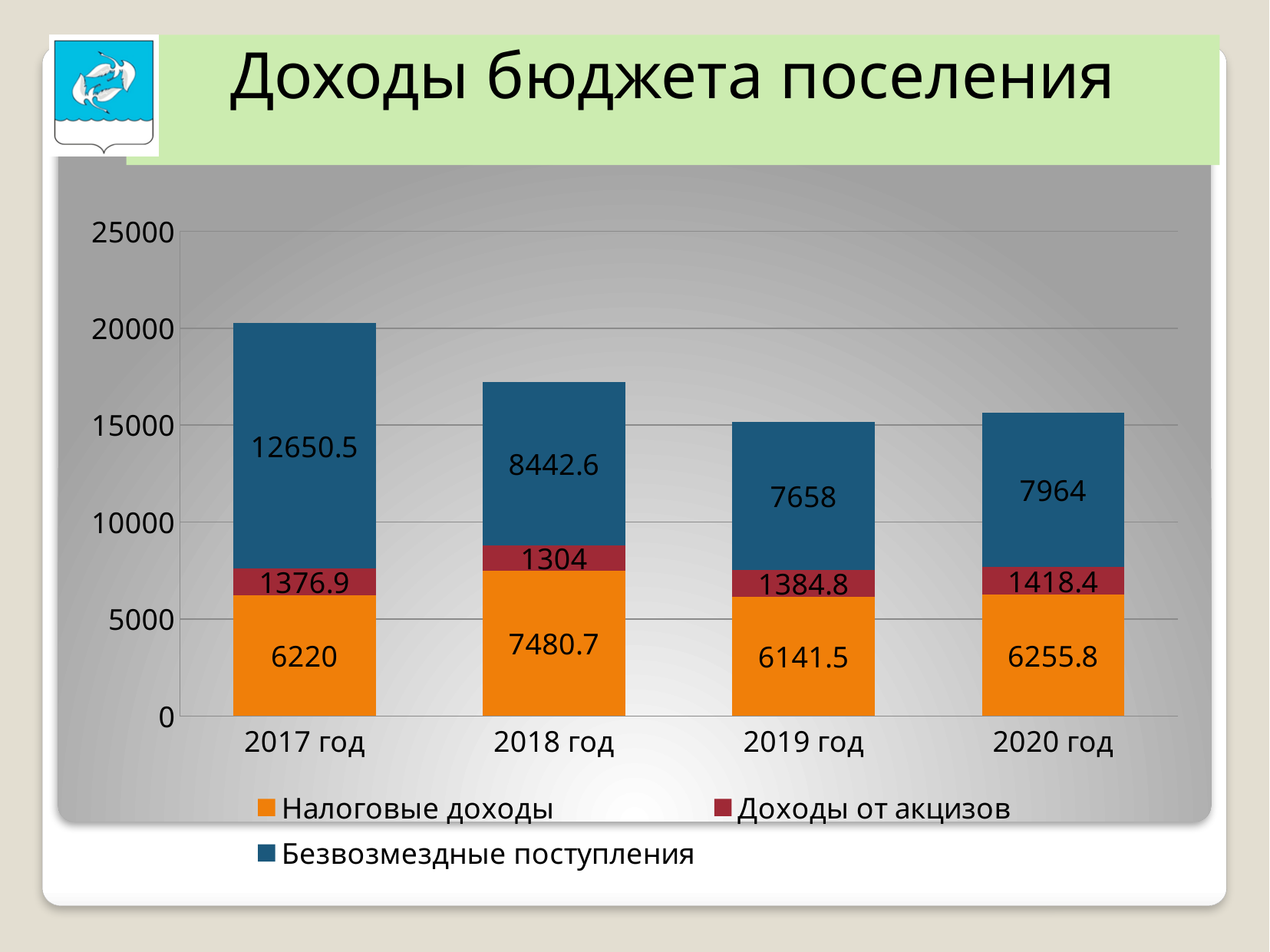
What is the value of Доходы от акцизов for 2020 год? 1418.4 What is the value of Налоговые доходы for 2018 год? 7480.7 What kind of chart is shown on the slide? Stacked bar chart How many years are shown on the x axis? 4 What is the value of Безвозмездные поступления for 2017 год? 12650.5 How many series does the legend list? 3 Which year has the highest value for Безвозмездные поступления? 2017 год What is the total of the stacked bar for 2017 год? 20247.4 Which year has the lowest value for Налоговые доходы? 2019 год Which is larger: Доходы от акцизов in 2019 год or in 2018 год? 2019 год What is the total of the stacked bar for 2019 год? 15184.3 What is the difference between Безвозмездные поступления in 2017 год and 2018 год? 4207.9